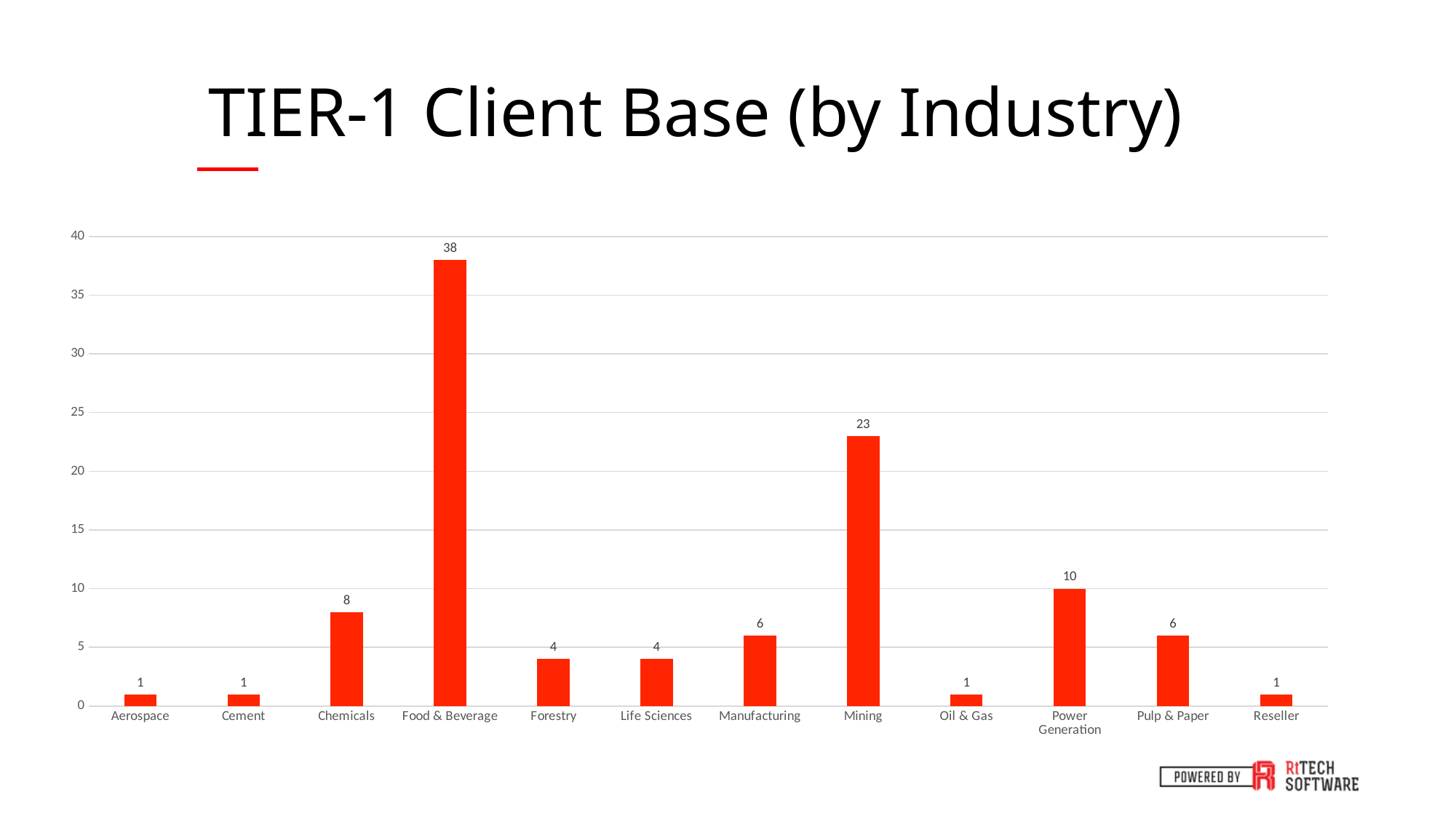
Which industry has the highest value? Food & Beverage What is the value for Power Generation? 10 What colour are the bars in the chart? red What is the value for Chemicals? 8 What is the title of the chart on the slide? TIER-1 Client Base (by Industry) What is the value for Mining? 23 How many industry categories are shown on the x axis? 12 Which is larger, the value for Power Generation or the value for Chemicals? Power Generation What is the value for Food & Beverage? 38 What is the difference between the values for Food & Beverage and Mining? 15 What kind of chart is shown on the slide? bar chart Is the value for Mining greater or less than 20? greater